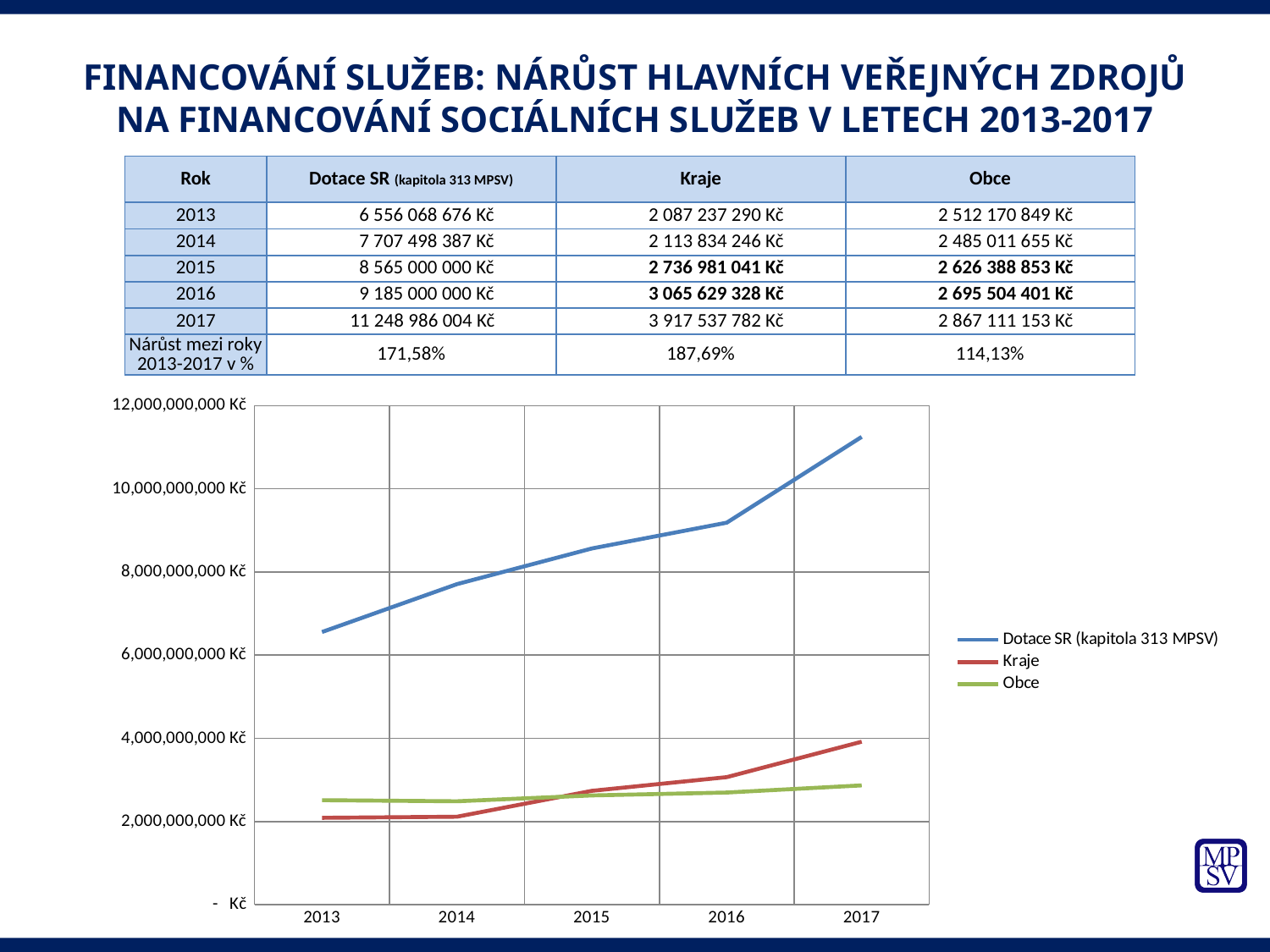
What kind of chart is shown on the slide? line chart How many years are plotted along the x axis of the chart? 5 Is the value for Dotace SR (kapitola 313 MPSV) in 2017 greater or less than 10,000,000,000 Kč? greater What is the value for Dotace SR (kapitola 313 MPSV) in 2017, as printed in the table? 11 248 986 004 Kč What is the value for Obce in 2013, as printed in the table? 2 512 170 849 Kč Which series has the highest values in the chart? Dotace SR (kapitola 313 MPSV) Is the value for Kraje in 2013 greater or less than 4,000,000,000 Kč? less Which series has the lowest value in 2017? Obce What colour is the Kraje line in the chart? red How many series does the chart legend list? 3 In 2017, which is larger: the value for Kraje or the value for Obce? Kraje Does the Dotace SR (kapitola 313 MPSV) line rise or fall from 2013 to 2017? rises